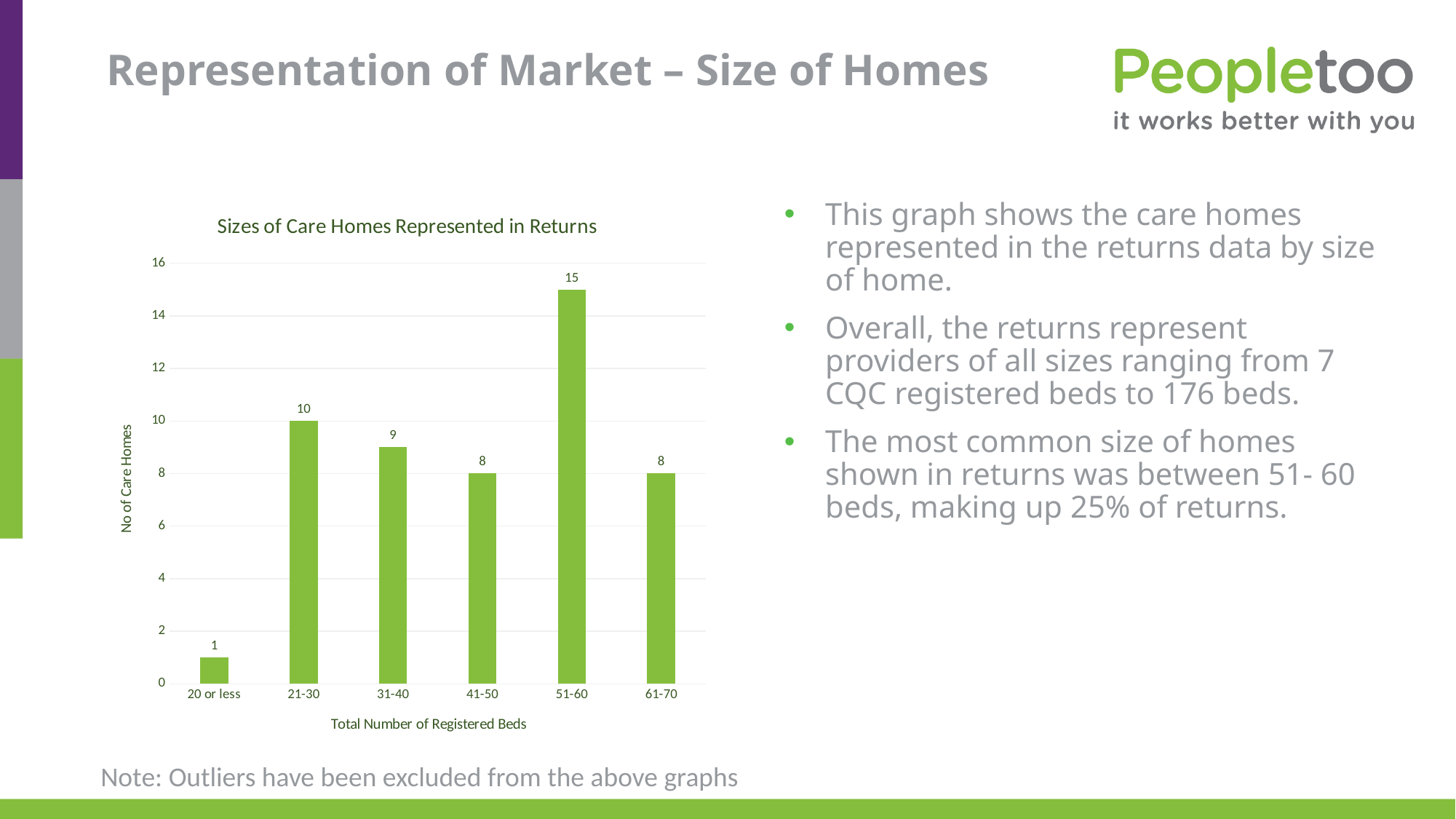
What is the number of care homes for the 51-60 beds category? 15 Which bed-size category has the lowest number of care homes? 20 or less What is the number of care homes for the 20 or less beds category? 1 Which has more care homes, the 31-40 category or the 41-50 category? 31-40 What is the difference between the number of care homes in the 51-60 category and the 21-30 category? 5 Is the value for the 51-60 category greater or less than 14? greater How many bed-size categories are shown on the x axis? 6 What is the title of the chart? Sizes of Care Homes Represented in Returns What is the number of care homes for the 31-40 beds category? 9 Which bed-size category has the highest number of care homes? 51-60 What is the number of care homes for the 21-30 beds category? 10 What type of chart is shown on the slide? Bar chart